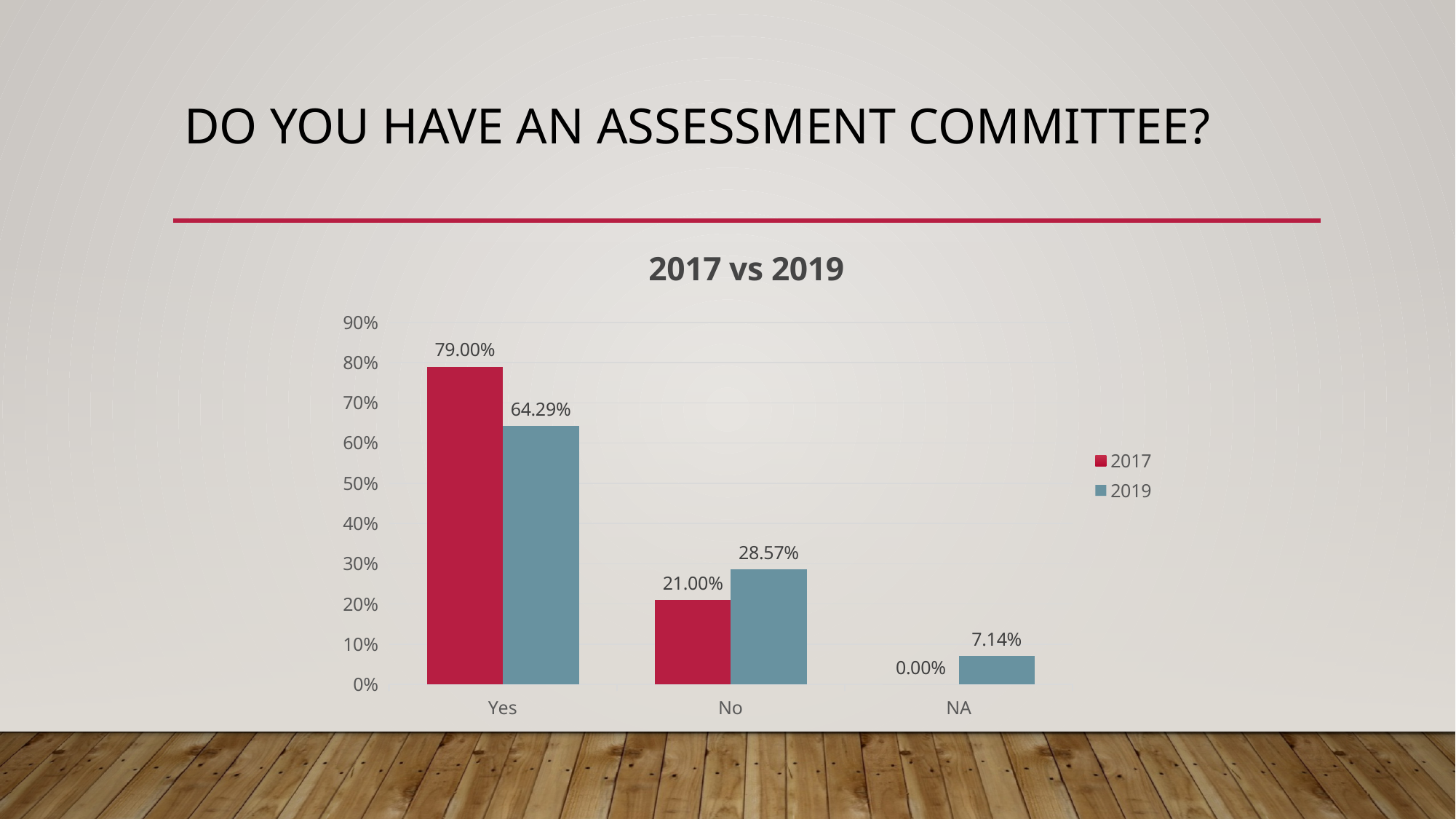
How many series does the legend list? 2 Which category has the lowest value in the 2017 series? NA What is the value for NA in the 2017 series? 0.00% What is the value for Yes in the 2019 series? 64.29% What is the value for No in the 2019 series? 28.57% Which is larger for No: the 2017 value or the 2019 value? 2019 How many categories are shown on the x axis? 3 What is the value for Yes in the 2017 series? 79.00% What is the difference between the 2017 and 2019 values for Yes? 14.71% What is the title of the chart? 2017 vs 2019 Which category has the highest value in the 2019 series? Yes What kind of chart is shown on the slide? Bar chart